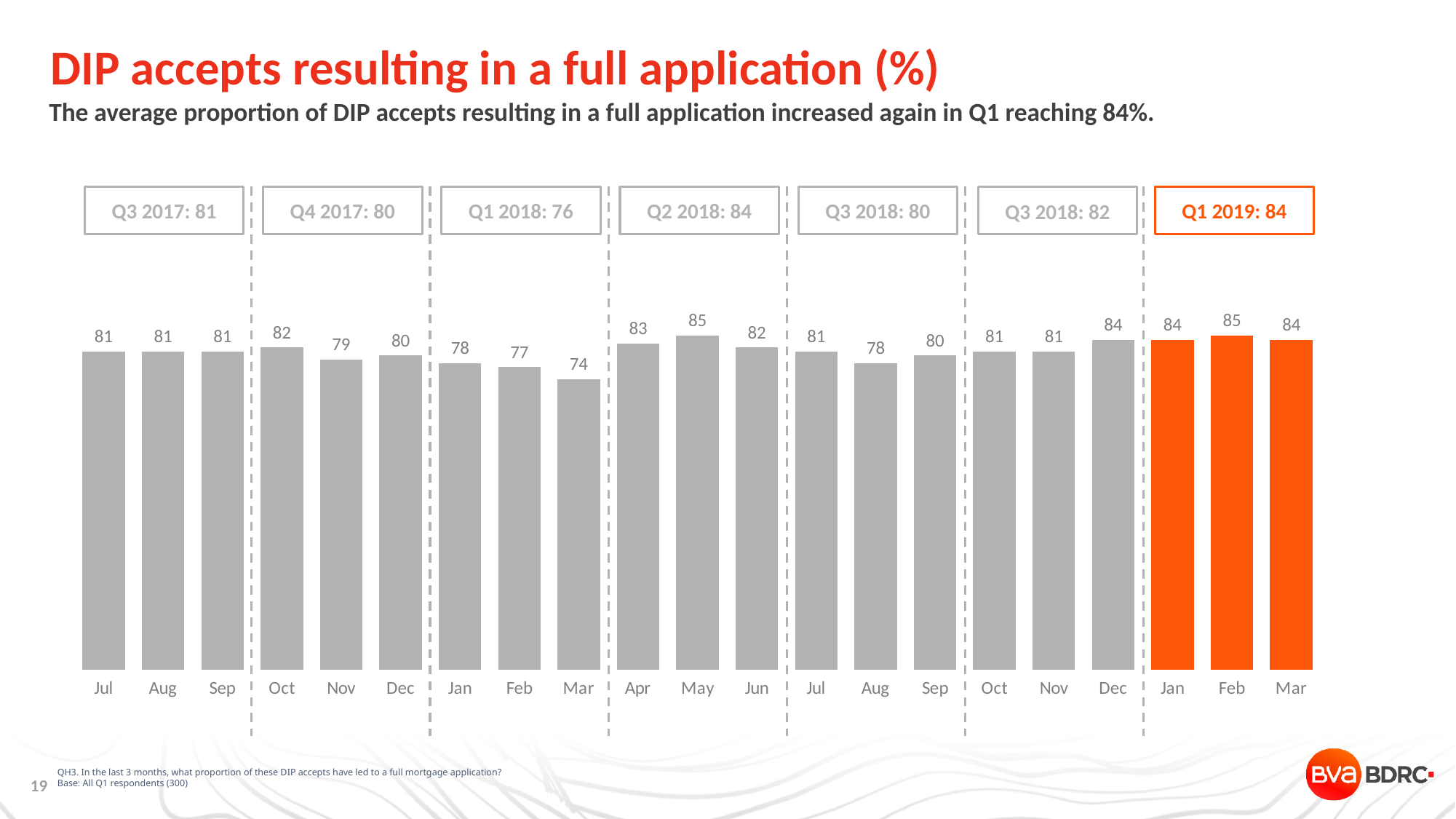
What is the quarterly average shown in the box for Q1 2018? 76 Which bars are highlighted in orange rather than grey? Jan, Feb and Mar of Q1 2019 What type of chart is shown on the slide? bar chart What is the value for Nov in the Q4 2017 period? 79 What is the quarterly average shown in the box for Q1 2019? 84 Which month has the lowest value in the chart? Mar (Q1 2018) What is the value for Feb in the Q1 2019 period? 85 How many monthly bars are plotted in the chart? 21 What is the difference between the value for May in Q2 2018 and the value for Mar in Q1 2018? 11 Do the values rise or fall from Jan to Mar in the Q1 2018 period? fall Which is larger: the value for Dec in Q4 2017 or the value for Dec in Q4 2018? Dec in Q4 2018 What is the value for Mar in the Q1 2018 period? 74